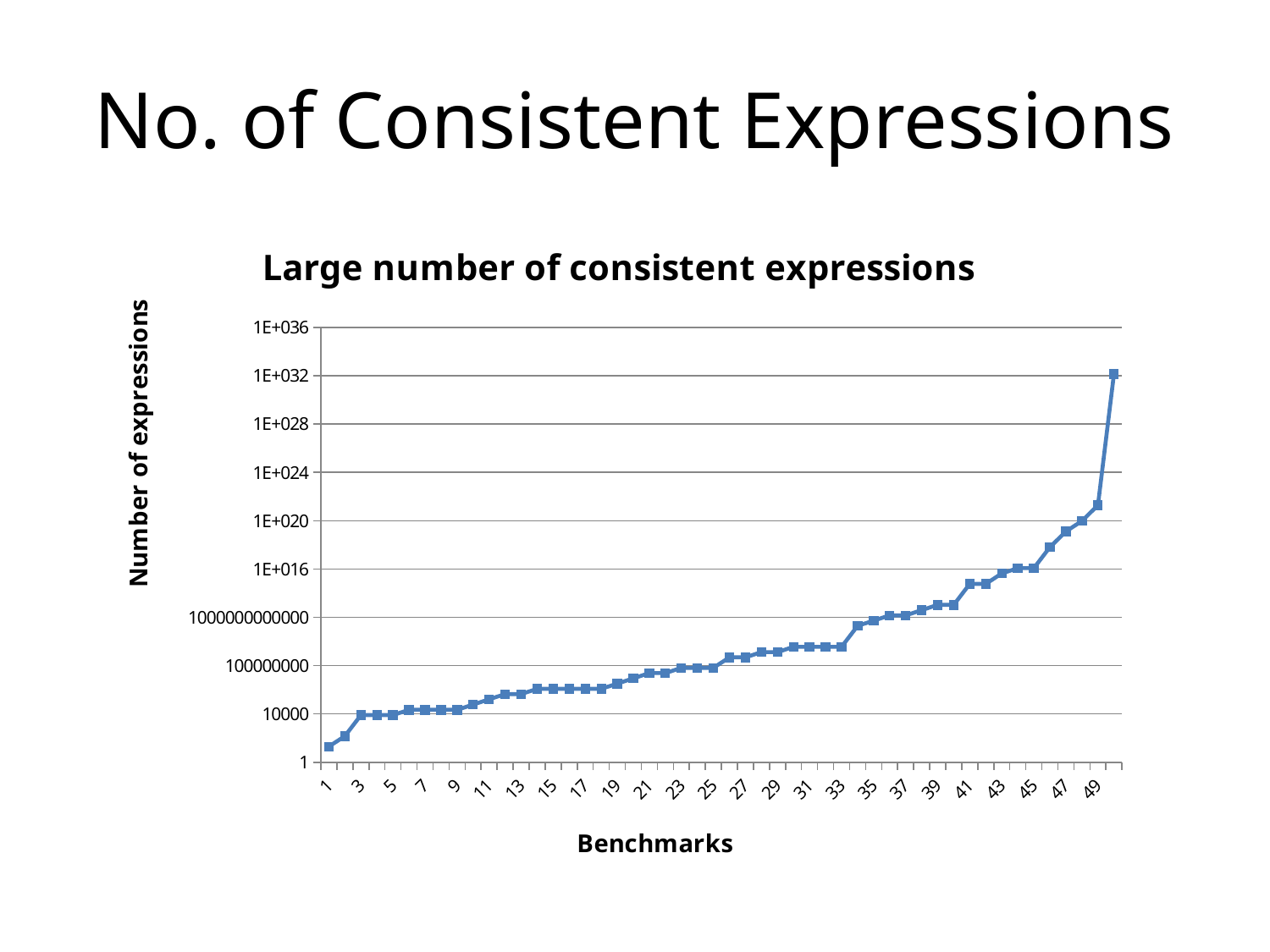
What is the title of the chart? Large number of consistent expressions What is the label of the y-axis? Number of expressions Is the value for the last (rightmost) benchmark greater or less than 1E+028? greater Is the value for benchmark 47 greater or less than 1E+016? greater What type of chart is shown on the slide? Line chart Which has a larger value, benchmark 1 or benchmark 49? Benchmark 49 Is the value for benchmark 3 greater or less than 100000000? less Do the values rise or fall as you move from benchmark 1 to the last benchmark along the x axis? Rise Which benchmark has the highest number of expressions? The last benchmark (rightmost point) Which has a larger value, benchmark 33 or benchmark 35? Benchmark 35 Which benchmark has the lowest number of expressions? Benchmark 1